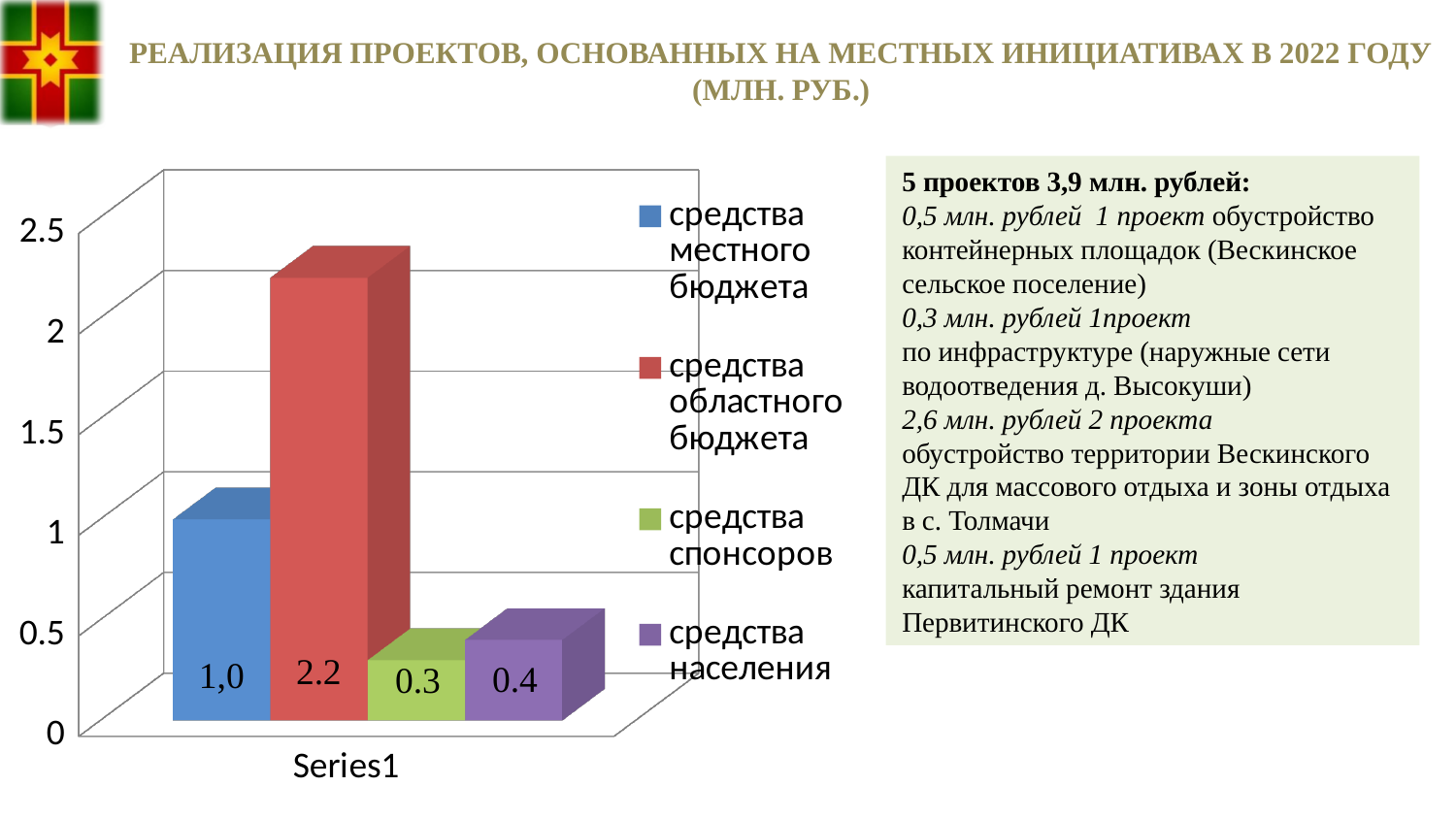
What colour is the bar for средства областного бюджета? red Which series has the lowest value? средства спонсоров What is the difference between the values for средства областного бюджета and средства местного бюджета? 1.2 What is the value for средства местного бюджета? 1,0 Which is larger, the value for средства населения or the value for средства спонсоров? средства населения What kind of chart is shown on the slide? bar chart What is the value for средства спонсоров? 0.3 What is the value for средства областного бюджета? 2.2 Is the value for средства областного бюджета greater or less than 2? greater How many series does the legend list? 4 Which series has the highest value? средства областного бюджета What is the value for средства населения? 0.4